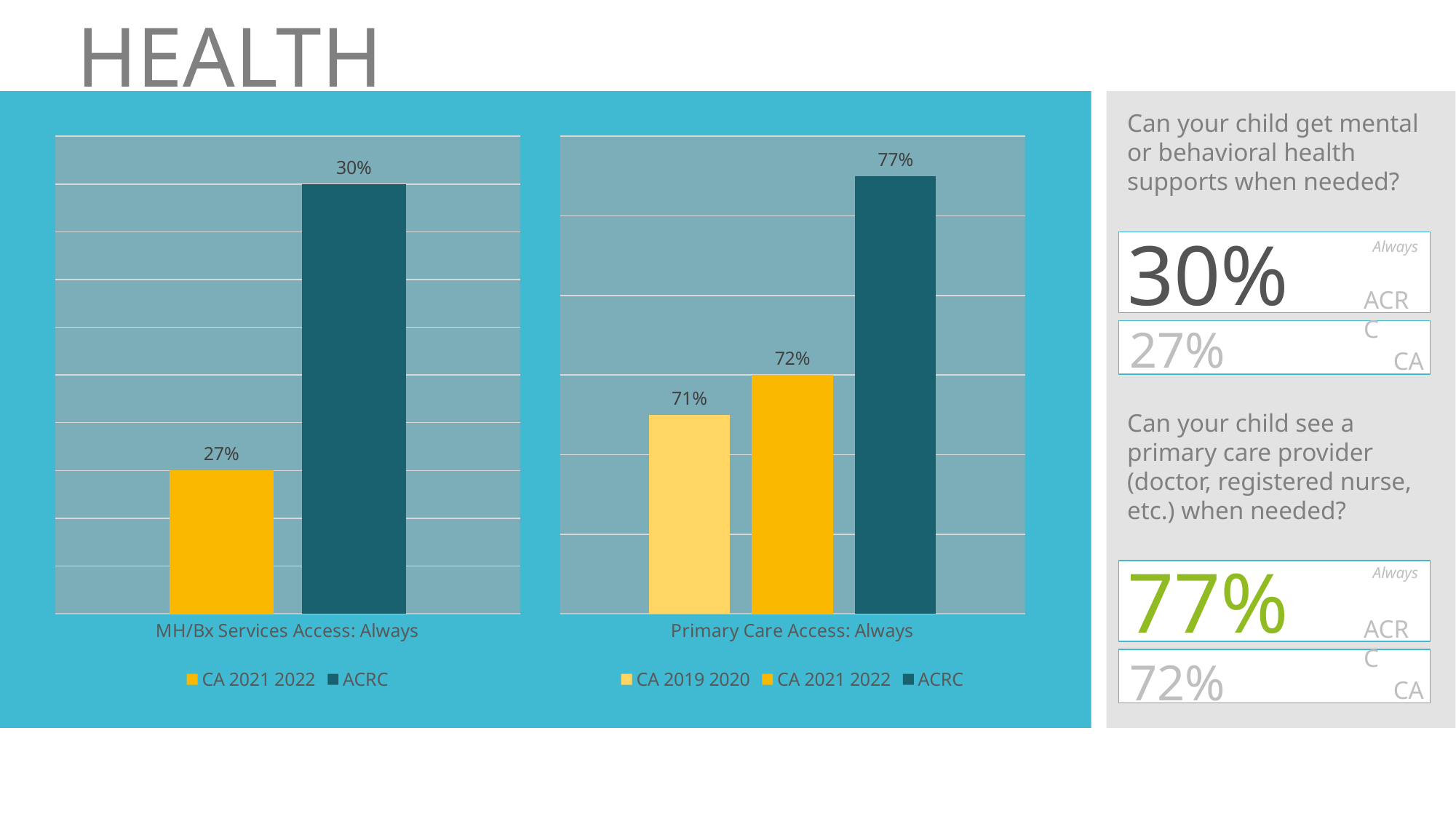
In the right chart (Primary Care Access: Always), which series has the lowest value? CA 2019 2020 In the left chart (MH/Bx Services Access: Always), what is the value for CA 2021 2022? 27% In the right chart (Primary Care Access: Always), which series has the highest value? ACRC In the left chart (MH/Bx Services Access: Always), which is larger, the ACRC value or the CA 2021 2022 value? ACRC How many series does the legend of the right chart (Primary Care Access: Always) list? 3 In the left chart (MH/Bx Services Access: Always), what is the difference between the ACRC value and the CA 2021 2022 value? 3% How many series does the legend of the left chart (MH/Bx Services Access: Always) list? 2 In the right chart (Primary Care Access: Always), what is the value for CA 2019 2020? 71% In the right chart (Primary Care Access: Always), what is the difference between the ACRC value and the CA 2021 2022 value? 5% In the left chart (MH/Bx Services Access: Always), what is the value for ACRC? 30% What kind of chart is the left chart (MH/Bx Services Access: Always)? Bar chart In the right chart (Primary Care Access: Always), what is the value for ACRC? 77%